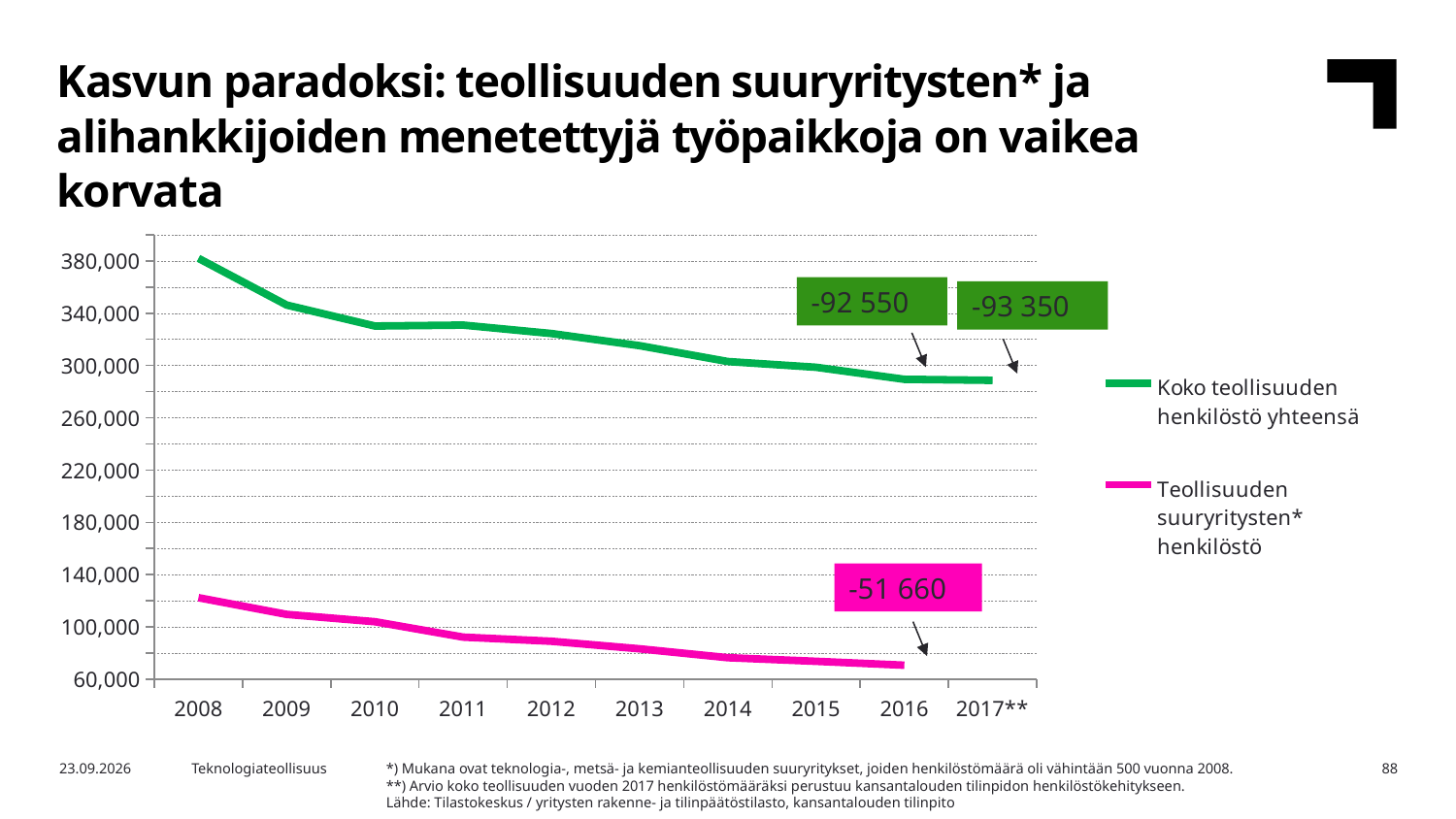
Is the value for 'Koko teollisuuden henkilöstö yhteensä' in 2016 greater or less than 260,000? greater Is the value for 'Teollisuuden suuryritysten* henkilöstö' in 2008 greater or less than 100,000? greater Which series has the higher value in 2012, 'Koko teollisuuden henkilöstö yhteensä' or 'Teollisuuden suuryritysten* henkilöstö'? Koko teollisuuden henkilöstö yhteensä Is the value for 'Koko teollisuuden henkilöstö yhteensä' in 2016 greater or less than 300,000? less Does the 'Koko teollisuuden henkilöstö yhteensä' line rise or fall from 2008 to 2016? Fall How many years are shown on the x axis? 10 What change is printed in the pink label above the 'Teollisuuden suuryritysten* henkilöstö' line? -51 660 How many series does the legend list? 2 Which year has the highest value for 'Koko teollisuuden henkilöstö yhteensä'? 2008 What kind of chart is shown on the slide? Line chart Does the 'Teollisuuden suuryritysten* henkilöstö' line rise or fall from 2008 to 2016? Fall